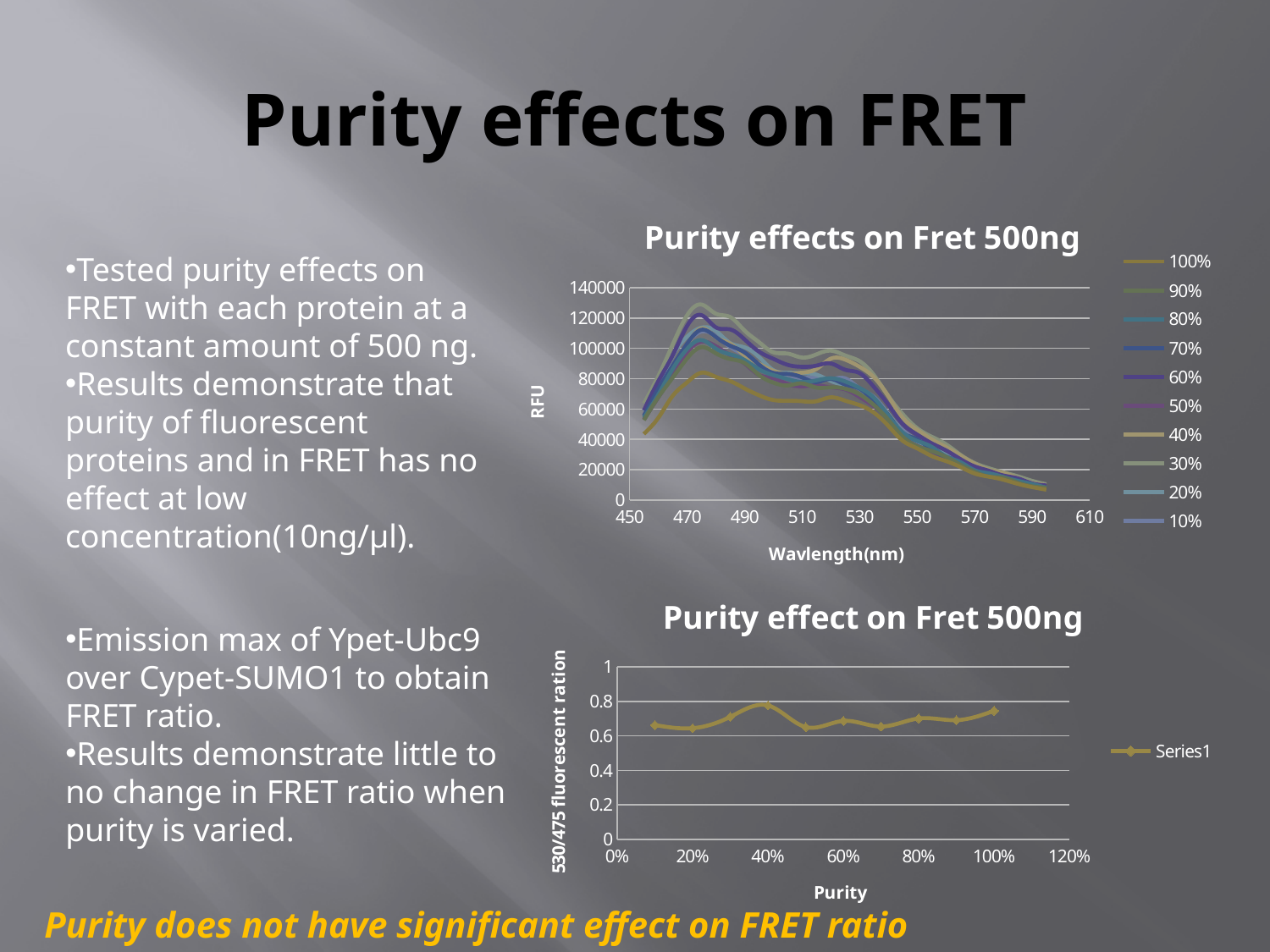
In the bottom chart 'Purity effect on Fret 500ng', what is the label of the y axis? 530/475 fluorescent ration In the bottom chart 'Purity effect on Fret 500ng', how many data points are plotted? 10 What kind of chart is the top chart titled 'Purity effects on Fret 500ng'? line chart In the top chart 'Purity effects on Fret 500ng', how many series does the legend list? 10 In the top chart 'Purity effects on Fret 500ng', are the values at 590 nm greater or less than 20000? less In the bottom chart 'Purity effect on Fret 500ng', how many series does the legend list? 1 In the bottom chart 'Purity effect on Fret 500ng', is the value at 40% purity greater or less than 0.6? greater In the top chart 'Purity effects on Fret 500ng', what is the label of the x axis? Wavlength(nm) In the top chart 'Purity effects on Fret 500ng', do the values rise or fall between 530 nm and 590 nm? fall In the bottom chart 'Purity effect on Fret 500ng', is the value at 20% purity greater or less than 0.8? less What kind of chart is the bottom chart titled 'Purity effect on Fret 500ng'? line chart